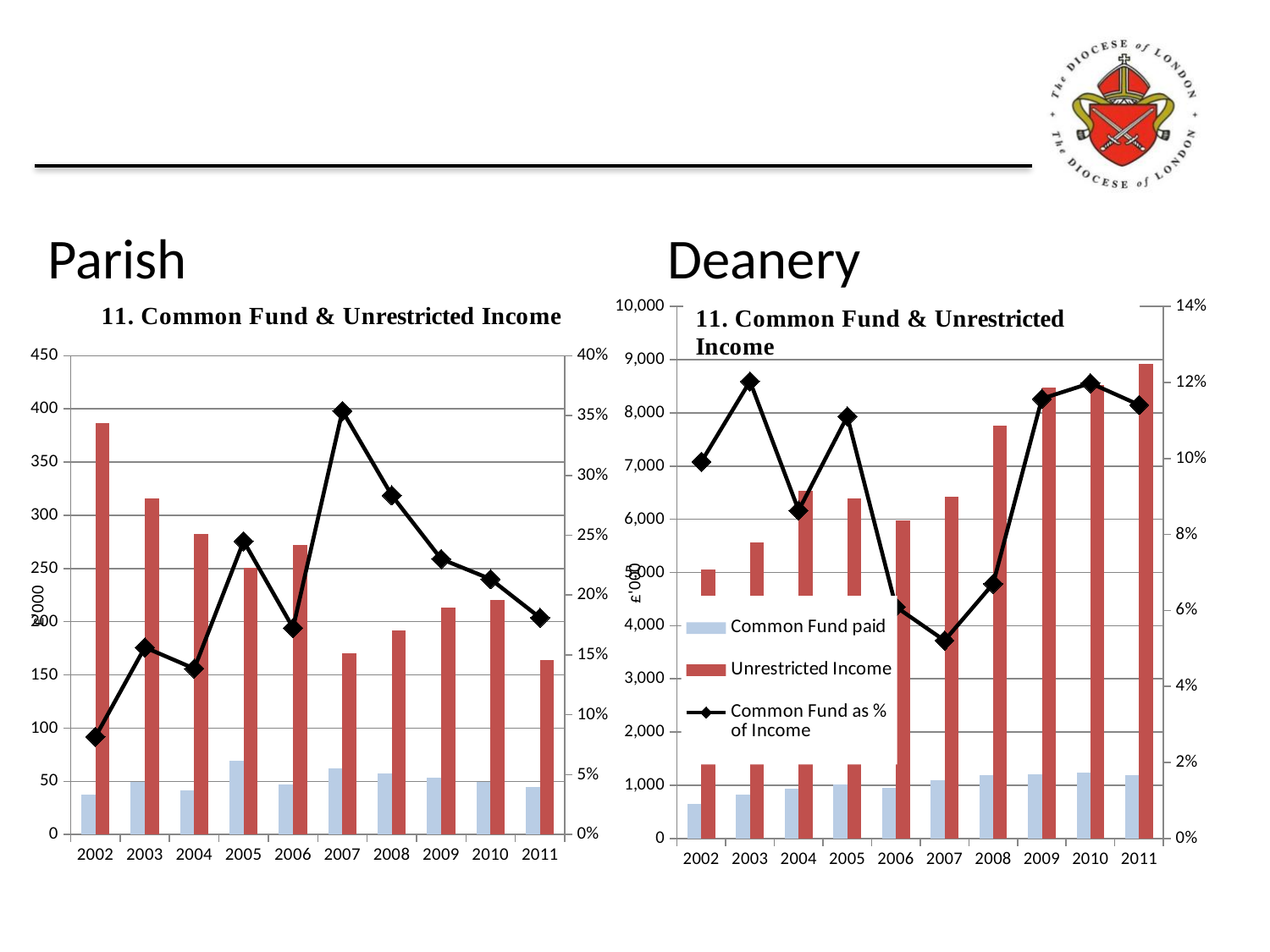
On the Deanery chart, is the Unrestricted Income value for 2011 greater or less than 8,000? greater How many years are shown on the x axis of the Parish chart? 10 How many series does the legend on the Deanery chart list? 3 On the Parish chart, is the Common Fund as % of Income for 2007 greater or less than 30%? greater On the Deanery chart, is the Unrestricted Income for 2008 larger or smaller than for 2007? larger On the Parish chart, does the Common Fund as % of Income line rise or fall from 2007 to 2011? fall On the Parish chart, is the Unrestricted Income value for 2002 greater or less than 350? greater On the Parish chart, which year has the highest Unrestricted Income bar? 2002 On the Deanery chart, in which year is the Common Fund as % of Income lowest? 2007 On the Parish chart, in which year is the Common Fund as % of Income lowest? 2002 On the Deanery chart, which year has the highest Unrestricted Income bar? 2011 On the Parish chart, in which year does the Common Fund as % of Income line reach its highest point? 2007